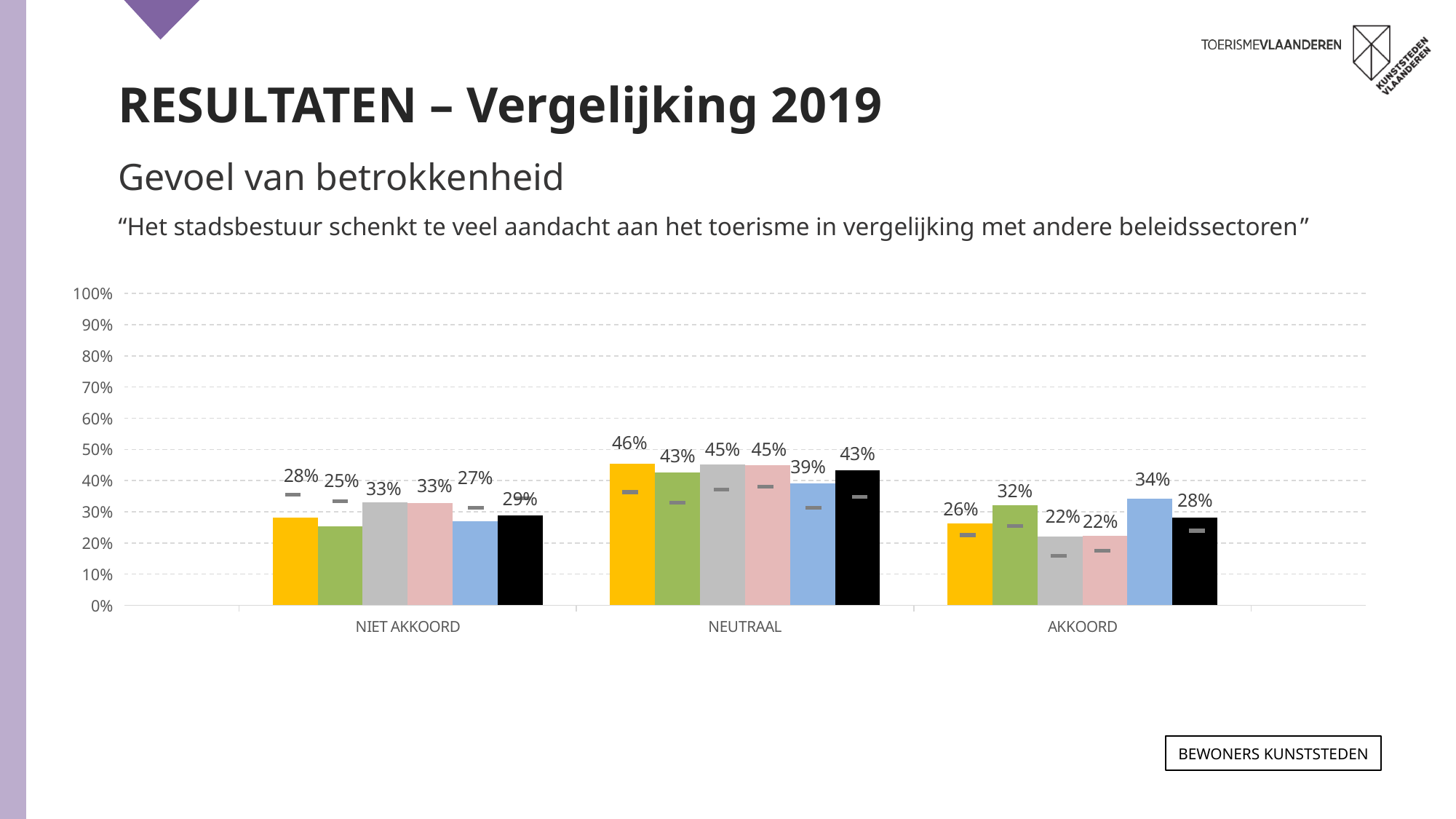
What is the value of the yellow bar in the NEUTRAAL category? 46% What type of chart is shown on the slide? bar chart Is the value of the blue bar in the NEUTRAAL category greater or less than 50%? less What is the value of the black bar in the NIET AKKOORD category? 29% Which is larger: the green bar in AKKOORD or the grey bar in AKKOORD? the green bar (32%) What is the difference between the yellow bar in NEUTRAAL (46%) and the yellow bar in AKKOORD (26%)? 20% What is the statement quoted above the chart? “Het stadsbestuur schenkt te veel aandacht aan het toerisme in vergelijking met andere beleidssectoren” Which bar has the highest value in the NEUTRAAL category? the yellow bar (46%) What is the value of the blue bar in the AKKOORD category? 34% Which bar has the lowest value in the NIET AKKOORD category? the green bar (25%) How many categories are shown on the x axis of the chart? 3 How many bars are plotted in each category of the chart? 6